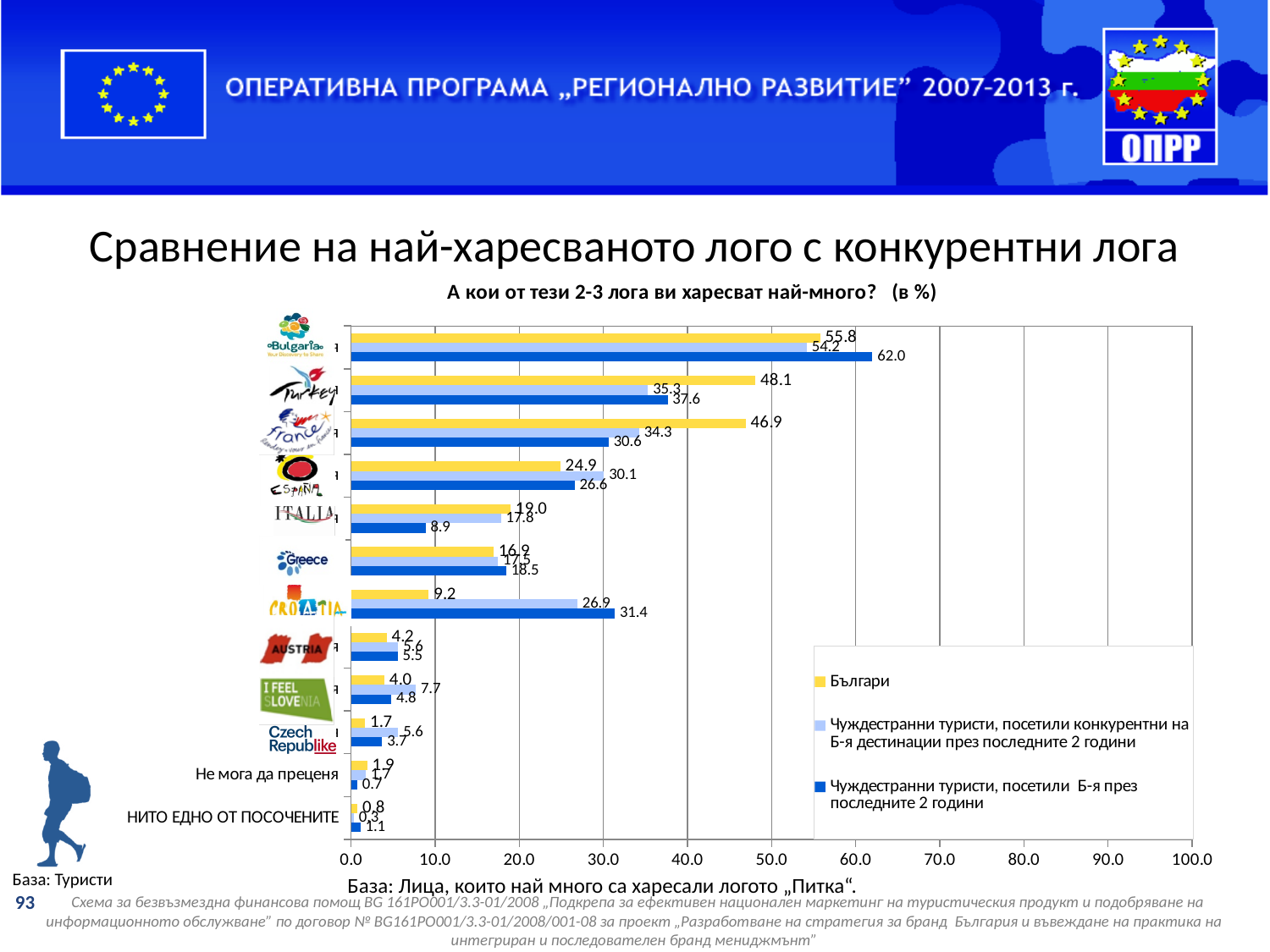
What is the value for Croatia in the series 'Чуждестранни туристи, посетили конкурентни на Б-я дестинации през последните 2 години'? 26.9 Is the 'Българи' value for Spain greater or less than 20.0? greater For Croatia, which is larger: the 'Българи' value or the 'Чуждестранни туристи, посетили Б-я през последните 2 години' value? Чуждестранни туристи, посетили Б-я през последните 2 години What is the value for Turkey in the 'Българи' series? 48.1 What is the title of the chart? А кои от тези 2-3 лога ви харесват най-много? (в %) Which category has the highest value in the 'Българи' series? Bulgaria What is the difference between the 'Българи' value for France (46.9) and the 'Чуждестранни туристи, посетили Б-я през последните 2 години' value for France (30.6)? 16.3 What type of chart is shown on the slide? bar chart How many categories are shown on the chart? 12 What is the value for Bulgaria in the series 'Чуждестранни туристи, посетили Б-я през последните 2 години'? 62.0 How many series does the legend list? 3 Which category has the lowest value in the 'Българи' series? НИТО ЕДНО ОТ ПОСОЧЕНИТЕ